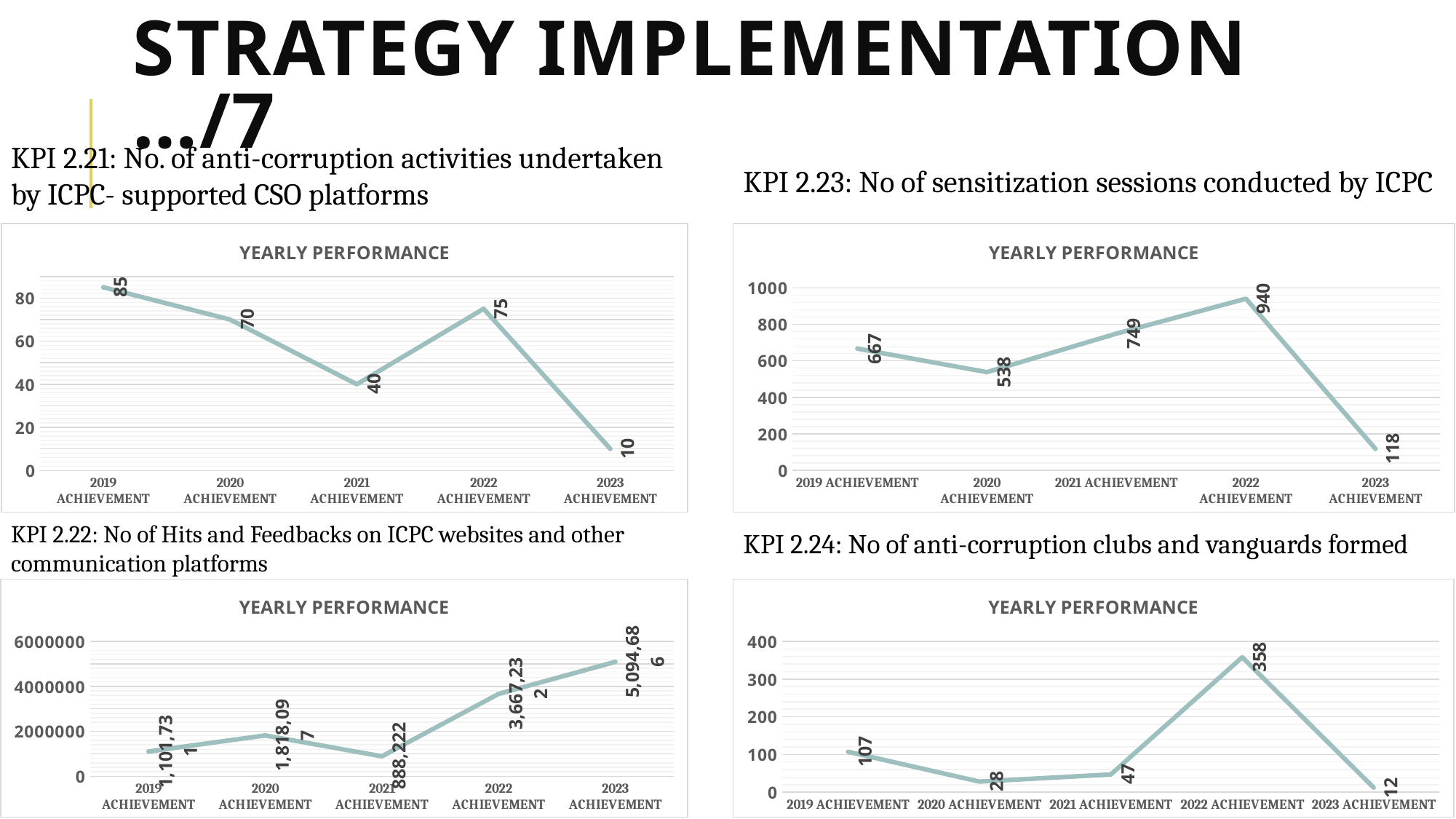
In the KPI 2.21 chart (anti-corruption activities by ICPC-supported CSO platforms), what is the value for 2019 Achievement? 85 In the KPI 2.23 chart (sensitization sessions conducted by ICPC), what is the value for 2022 Achievement? 940 In the KPI 2.22 chart (hits and feedbacks on ICPC websites), what is the value for 2021 Achievement? 888,222 In the KPI 2.21 chart, which year has the lowest value? 2023 Achievement What type of chart is used for KPI 2.21? line chart In the KPI 2.24 chart (anti-corruption clubs and vanguards formed), what is the value for 2022 Achievement? 358 How many data points are plotted in the KPI 2.24 chart? 5 In the KPI 2.24 chart, what is the difference between the 2019 and 2020 values? 79 In the KPI 2.21 chart, what is the difference between the 2022 and 2021 values? 35 In the KPI 2.23 chart, which year has the highest value? 2022 Achievement In the KPI 2.23 chart, is the value for 2020 Achievement larger or smaller than the value for 2021 Achievement? smaller In the KPI 2.22 chart, is the value for 2023 Achievement greater or less than 4000000? greater